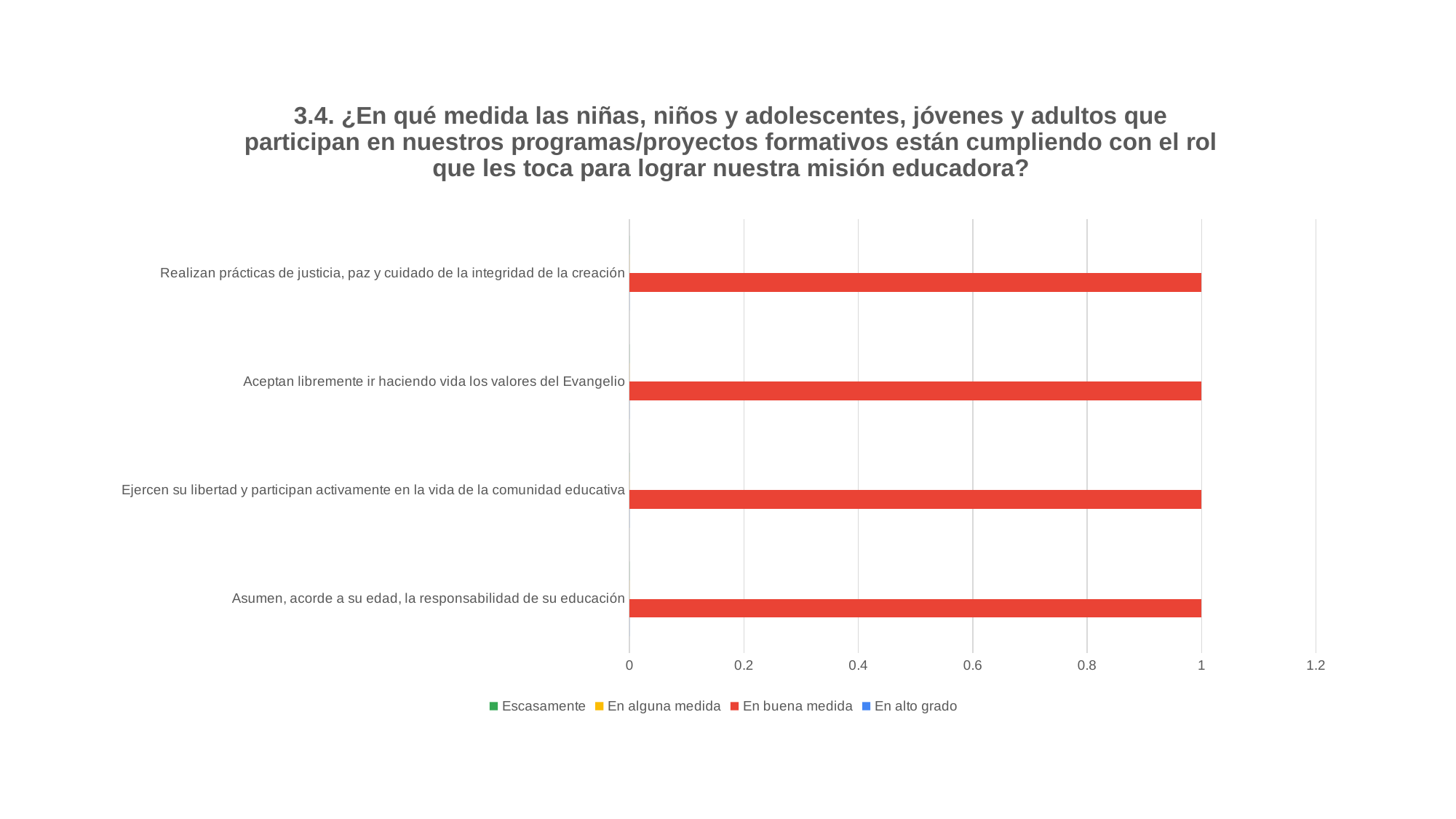
What is the difference between the 'En buena medida' values for 'Asumen, acorde a su edad, la responsabilidad de su educación' and 'Realizan prácticas de justicia, paz y cuidado de la integridad de la creación'? 0 What kind of chart is shown on the slide? bar chart What is the highest value shown on the horizontal axis of the chart? 1.2 How many series does the chart's legend list? 4 What is the value of the 'En buena medida' bar for 'Ejercen su libertad y participan activamente en la vida de la comunidad educativa'? 1 Is the 'En buena medida' value for 'Ejercen su libertad y participan activamente en la vida de la comunidad educativa' greater or less than 0.8? greater Is the 'En buena medida' value for 'Aceptan libremente ir haciendo vida los valores del Evangelio' greater or less than 1.2? less Which legend series is shown in red in the chart? En buena medida How many categories are listed on the vertical axis of the chart? 4 What is the value of the 'En buena medida' bar for 'Realizan prácticas de justicia, paz y cuidado de la integridad de la creación'? 1 What is the value of the 'En buena medida' bar for 'Asumen, acorde a su edad, la responsabilidad de su educación'? 1 What is the value of the 'En buena medida' bar for 'Aceptan libremente ir haciendo vida los valores del Evangelio'? 1